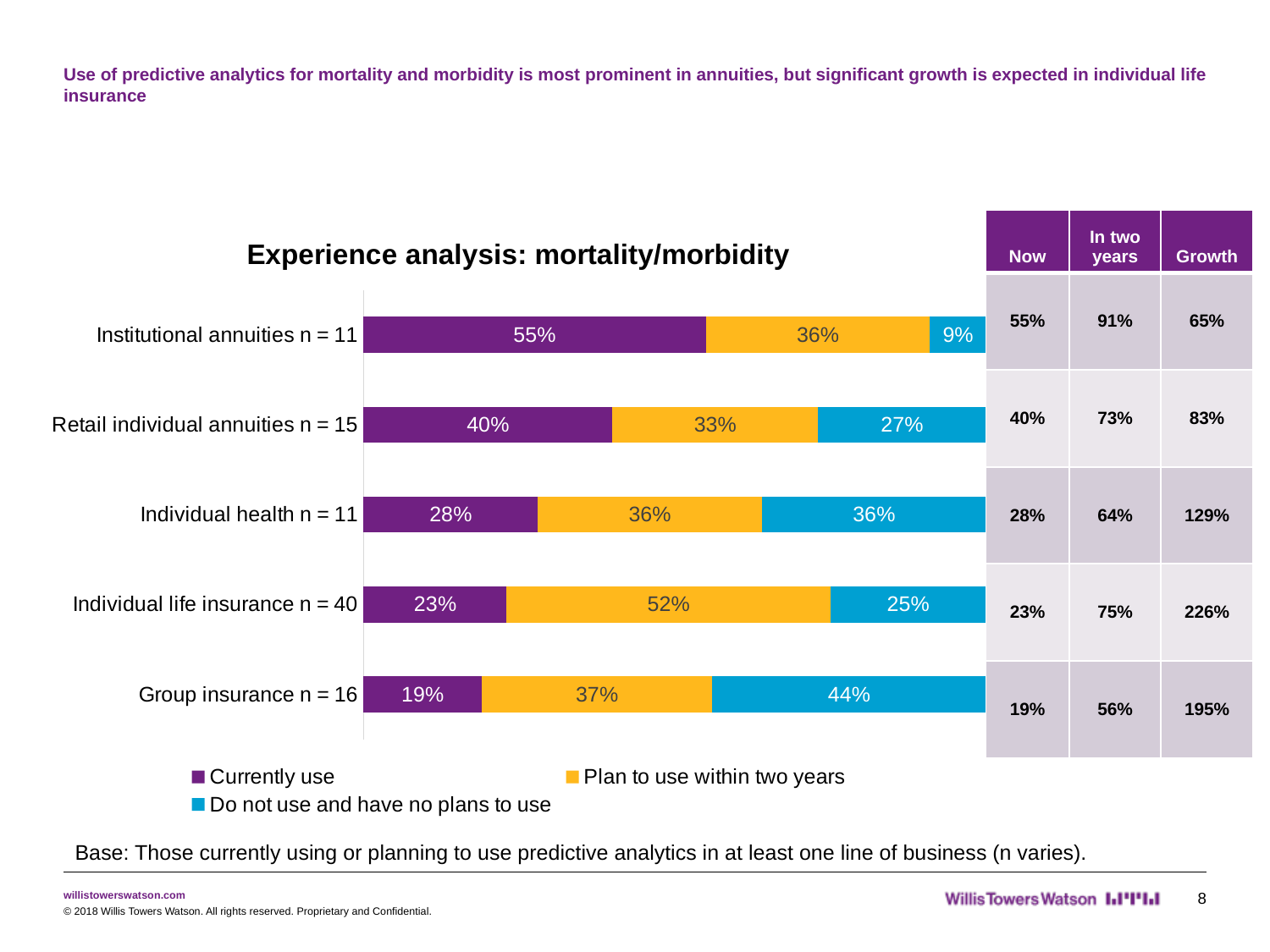
What is the 'Do not use and have no plans to use' value for Group insurance? 44% What is the 'Currently use' value for Institutional annuities? 55% Which category has the highest 'Currently use' value? Institutional annuities n = 11 Which category has the lowest 'Currently use' value? Group insurance n = 16 What is the difference between the 'Currently use' values for Retail individual annuities and Individual health? 12% How many series does the chart legend list? 3 What is the title of the chart? Experience analysis: mortality/morbidity Which is larger: the 'Plan to use within two years' value for Individual life insurance or for Group insurance? Individual life insurance What kind of chart is shown on the slide? Stacked bar chart What is the 'Plan to use within two years' value for Individual life insurance? 52% How many categories (lines of business) are plotted in the chart? 5 What is the combined 'Currently use' and 'Plan to use within two years' value for Retail individual annuities? 73%